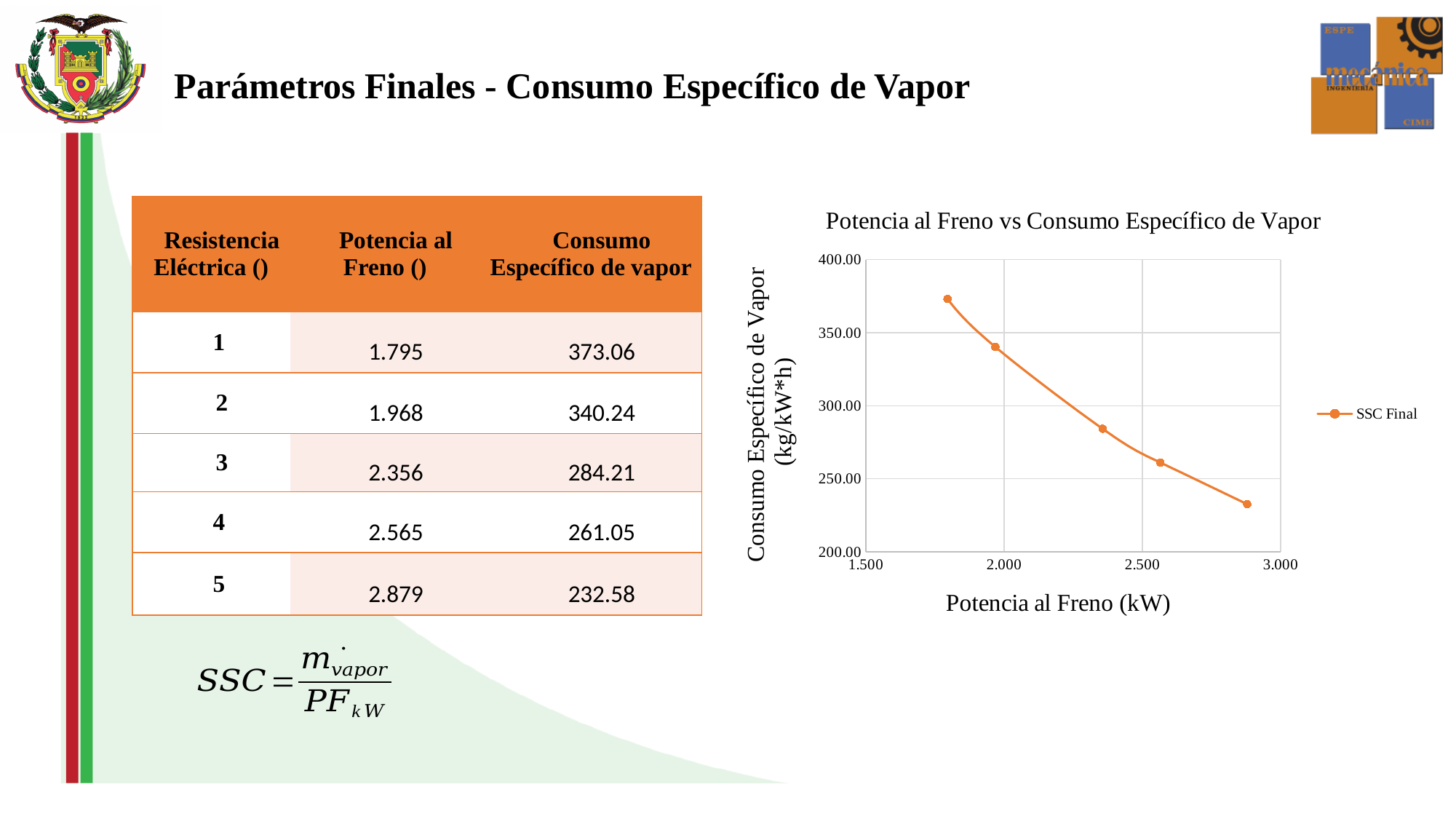
According to the table, what is the Consumo Específico de vapor at a Potencia al Freno of 2.879? 232.58 Does the Consumo Específico de Vapor rise or fall as Potencia al Freno increases along the x axis? fall What is the title of the chart? Potencia al Freno vs Consumo Específico de Vapor What kind of chart is shown on the slide? line chart Is the SSC Final value at the leftmost point (around 1.8 kW) greater or less than 350.00? greater Is the SSC Final value at the rightmost point (around 2.9 kW) greater or less than 250.00? less Is the SSC Final value at the middle point (around 2.35 kW) greater or less than 300.00? less According to the table, what is the Consumo Específico de vapor at a Potencia al Freno of 1.795? 373.06 What is the label of the chart's x axis? Potencia al Freno (kW) Using the table values, what is the difference between the Consumo Específico de vapor at 1.795 kW and at 2.879 kW? 140.48 How many data points are plotted on the chart? 5 How many series does the chart legend list? 1